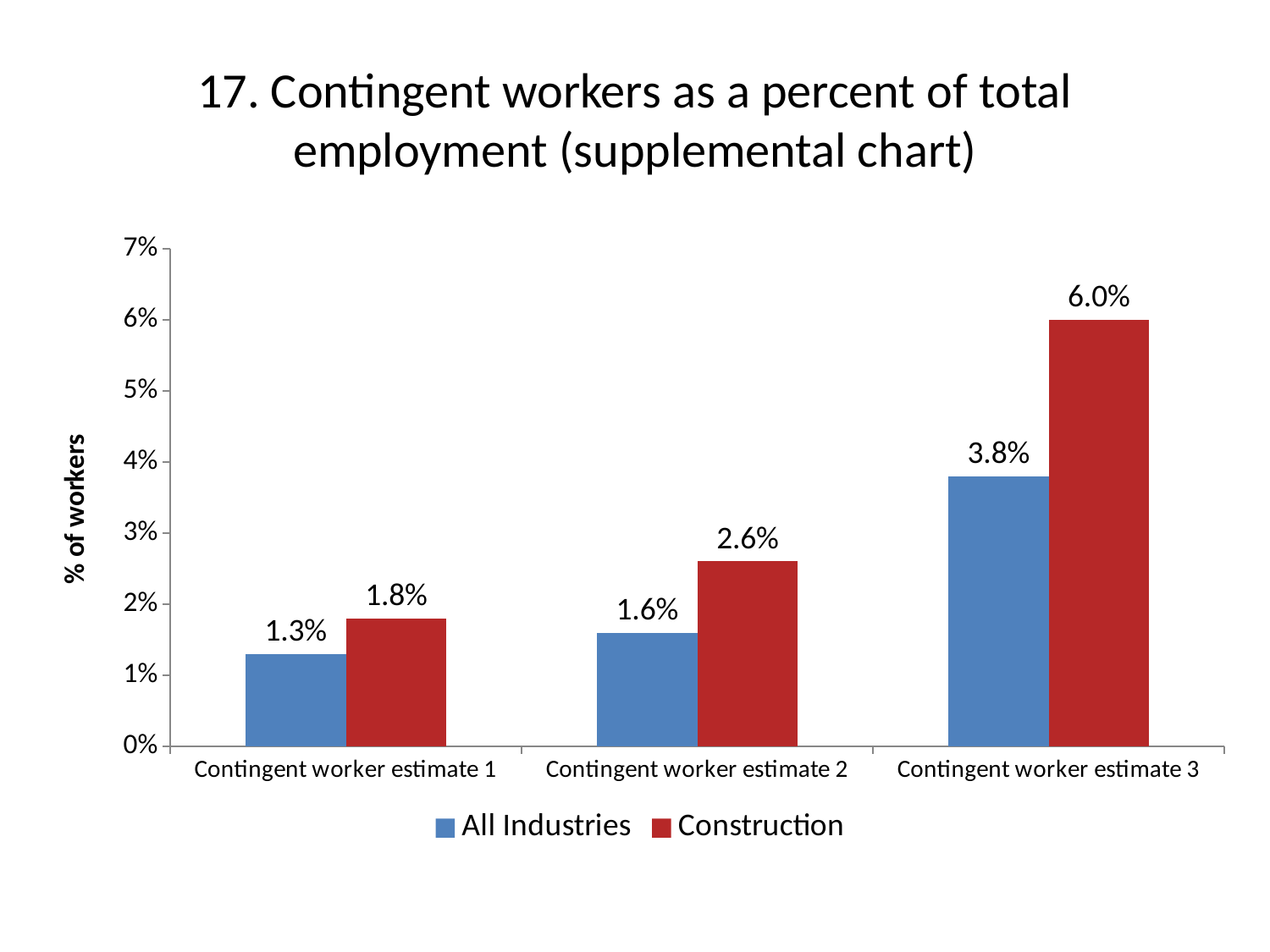
Which is larger under Contingent worker estimate 2: All Industries or Construction? Construction What kind of chart is shown on the slide? Bar chart Do the All Industries values rise or fall from Contingent worker estimate 1 to Contingent worker estimate 3? Rise What is the value for All Industries under Contingent worker estimate 1? 1.3% How many series does the legend list? 2 What is the value for Construction under Contingent worker estimate 3? 6.0% What is the difference between Construction and All Industries under Contingent worker estimate 3? 2.2% Which category has the highest value for All Industries? Contingent worker estimate 3 Which category has the lowest value for Construction? Contingent worker estimate 1 What is the difference between Construction and All Industries under Contingent worker estimate 1? 0.5% How many categories are shown on the x axis? 3 What is the value for Construction under Contingent worker estimate 2? 2.6%